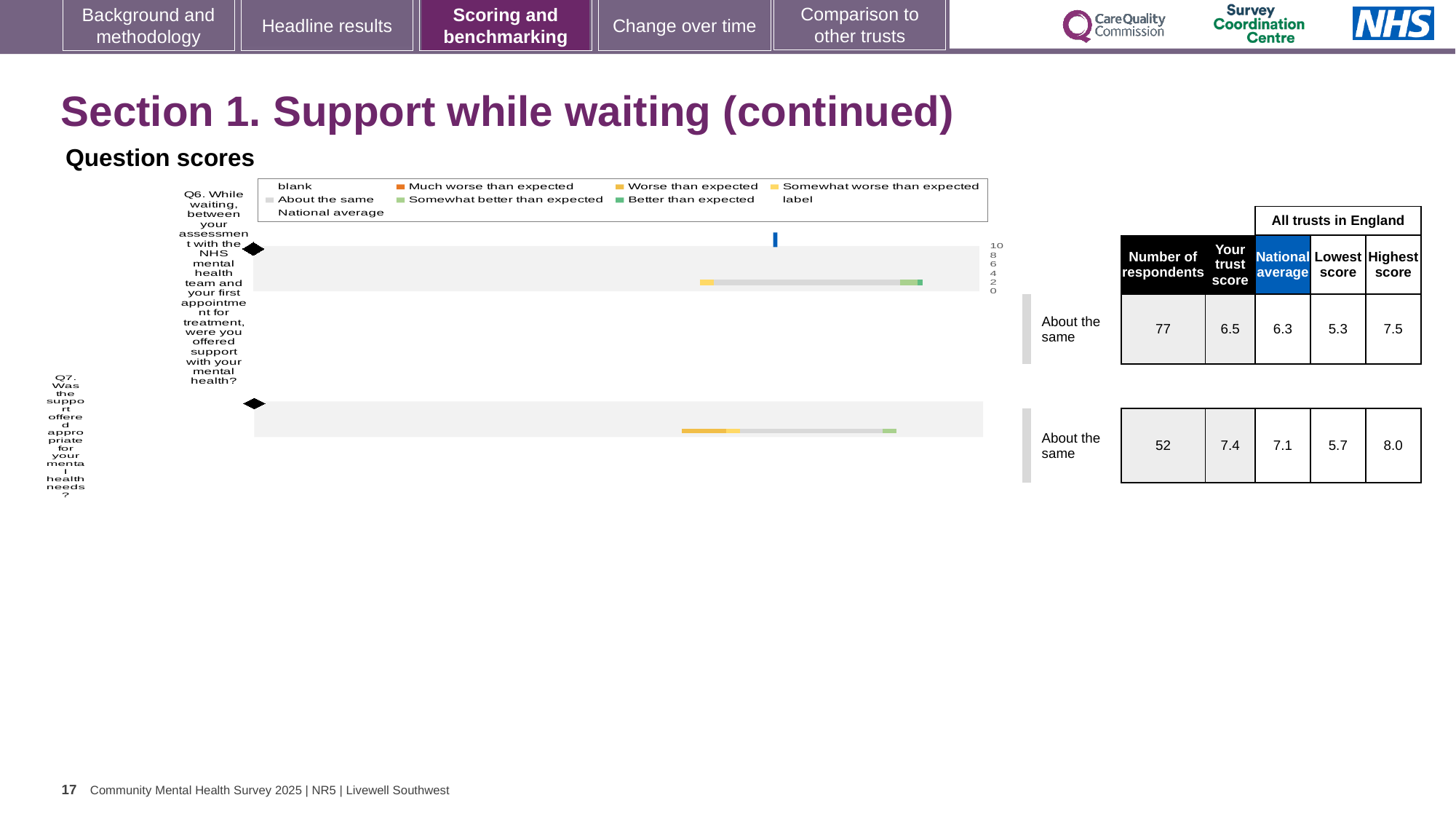
How many respondents answered Q7? 52 How many questions (bars) are plotted on the slide? 2 What is the highest score across all trusts in England for Q7? 8.0 For Q6, what is the trust's score shown in the table next to the chart? 6.5 What is the difference between the highest and lowest scores for Q6? 2.2 What is the maximum value shown on the score axis of the chart? 10 Which question has the higher trust score, Q6 or Q7? Q7 For Q7, what is the national average score shown in the table? 7.1 What kind of chart is used to show the question scores for Q6 and Q7? bar chart How many respondents answered Q6? 77 What is the difference between the trust score and the national average for Q7? 0.3 What is the lowest score across all trusts in England for Q6? 5.3